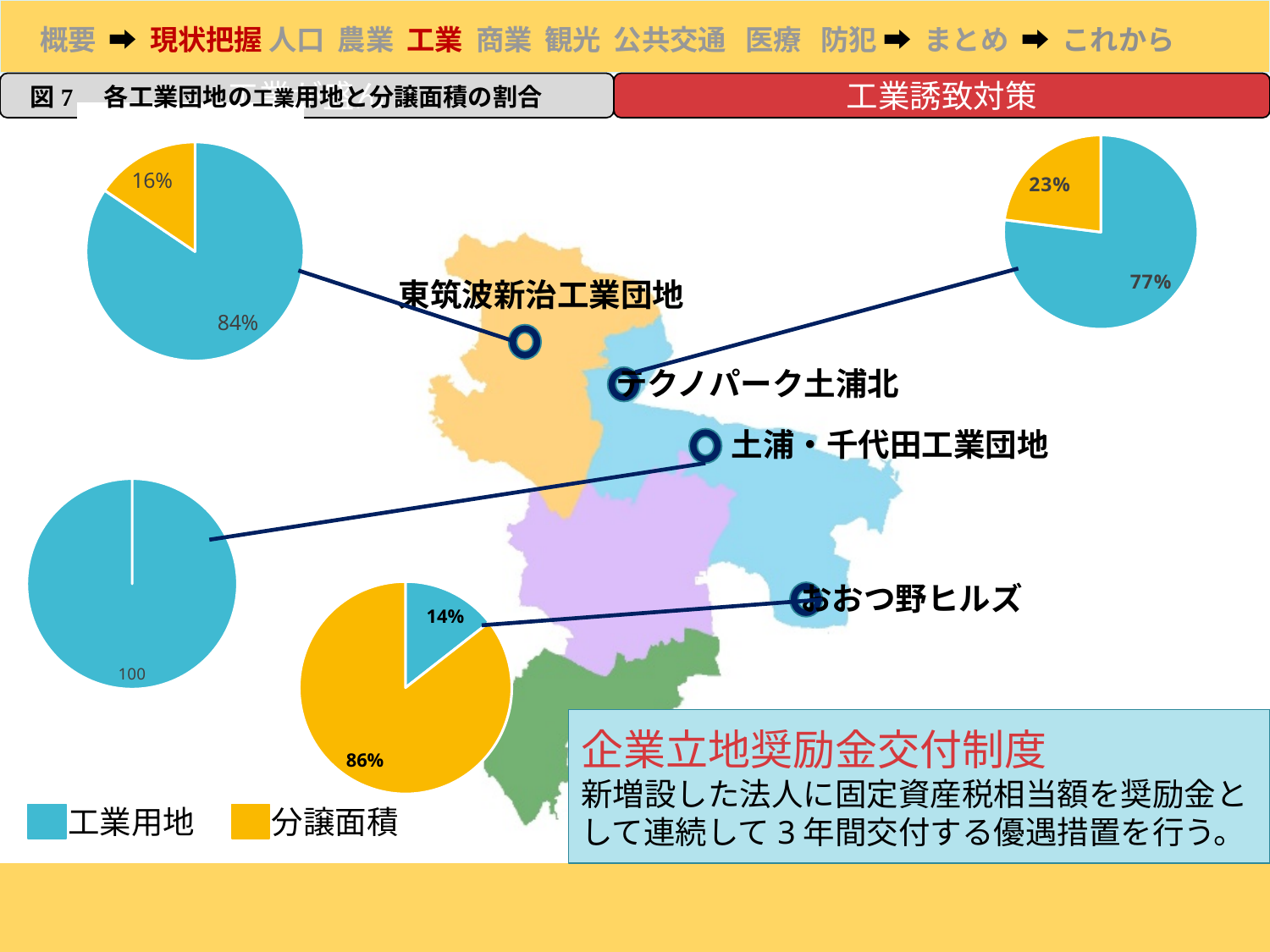
In the pie chart for テクノパーク土浦北 (top-right), what share is labelled for 工業用地? 77% What value is labelled on the pie chart for 土浦・千代田工業団地 (bottom-left)? 100 In the pie chart for テクノパーク土浦北 (top-right), what share is labelled for 分譲面積? 23% How many pie charts are shown on the slide? 4 In the pie chart for おおつ野ヒルズ (bottom-middle), what share is labelled for 工業用地? 14% In the pie chart for おおつ野ヒルズ (bottom-middle), which slice is larger, 工業用地 or 分譲面積? 分譲面積 What kind of charts are used on this slide to show the shares for each industrial park? Pie charts In the pie chart for テクノパーク土浦北 (top-right), what is the difference between the 工業用地 share and the 分譲面積 share? 54% How many series does the legend at the bottom of the slide list? 2 In the pie chart for 東筑波新治工業団地 (top-left), what share is labelled for 工業用地? 84% In the pie chart for おおつ野ヒルズ (bottom-middle), what share is labelled for 分譲面積? 86% In the pie chart for 東筑波新治工業団地 (top-left), what share is labelled for 分譲面積? 16%